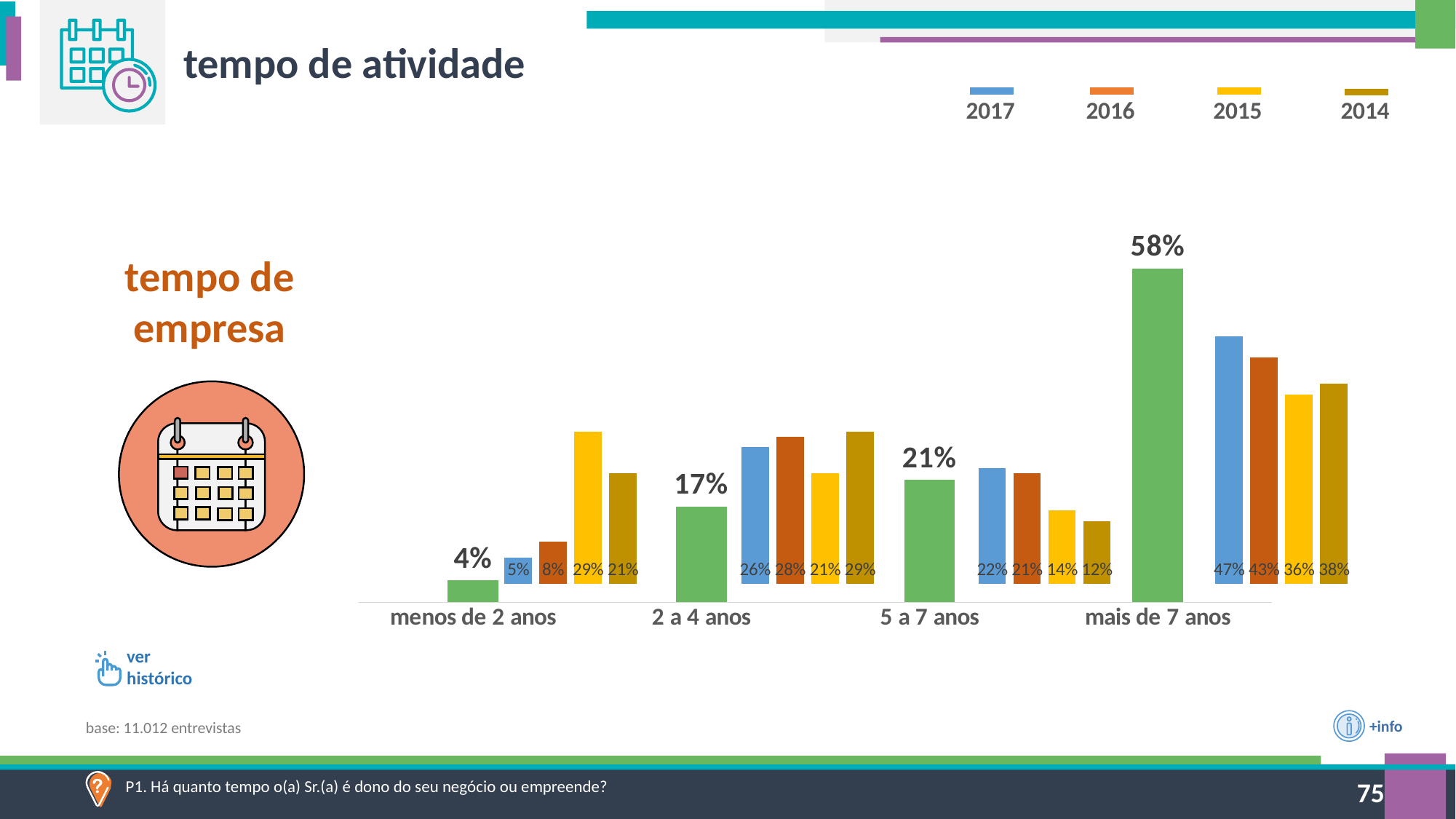
Which category has the lowest 2016 value? menos de 2 anos What kind of chart is shown on the slide? bar chart Which category has the highest value among the green bars? mais de 7 anos What is the 2015 value for '5 a 7 anos'? 14% How many categories are shown on the x axis of the chart? 4 For '2 a 4 anos', which is larger: the 2016 value or the 2015 value? 2016 What is the difference between the 2017 and 2014 values for 'mais de 7 anos'? 9% How many series does the legend at the top of the slide list? 4 What is the 2017 value for 'menos de 2 anos'? 5% What is the 2014 value for '2 a 4 anos'? 29% Do the green bars rise or fall from 'menos de 2 anos' to 'mais de 7 anos'? rise What is the value of the large green bar for 'mais de 7 anos'? 58%